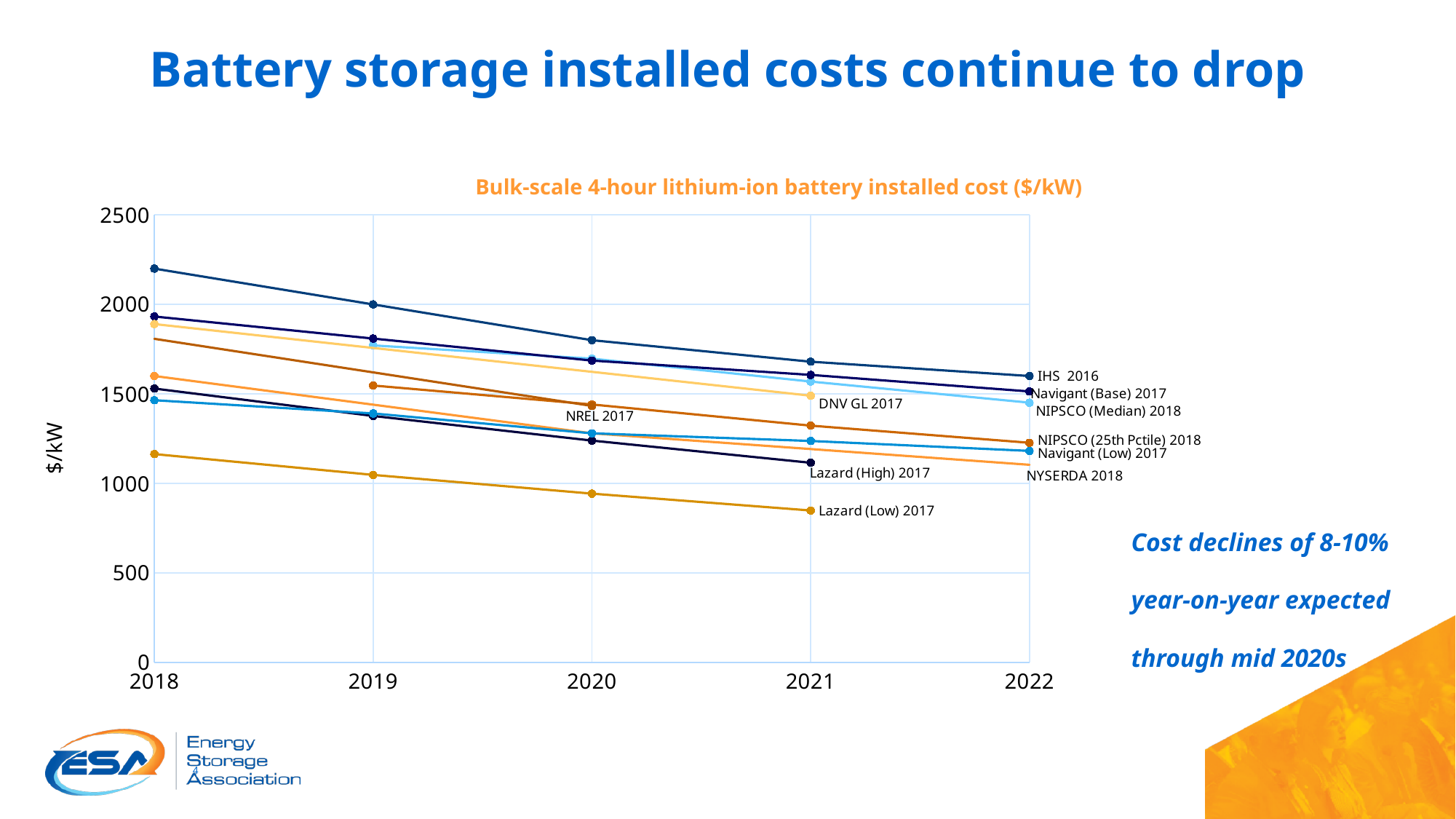
Is the value for Lazard (Low) 2017 in 2021 greater or less than 1000? less What is the label on the y axis of the chart? $/kW What is the title of the chart? Bulk-scale 4-hour lithium-ion battery installed cost ($/kW) Is the value for IHS 2016 in 2022 greater or less than 1500? greater Which is larger in 2022, the value for IHS 2016 or the value for NYSERDA 2018? IHS 2016 Which is larger in 2021, the value for Lazard (High) 2017 or the value for Lazard (Low) 2017? Lazard (High) 2017 Is the value for IHS 2016 in 2018 greater or less than 2000? greater Which series has the highest value in 2018? IHS 2016 How many years are shown on the x axis of the chart? 5 What kind of chart is shown on the slide? line chart Which series has the lowest value in 2018? Lazard (Low) 2017 Do the installed cost lines rise or fall from 2018 to 2022? fall